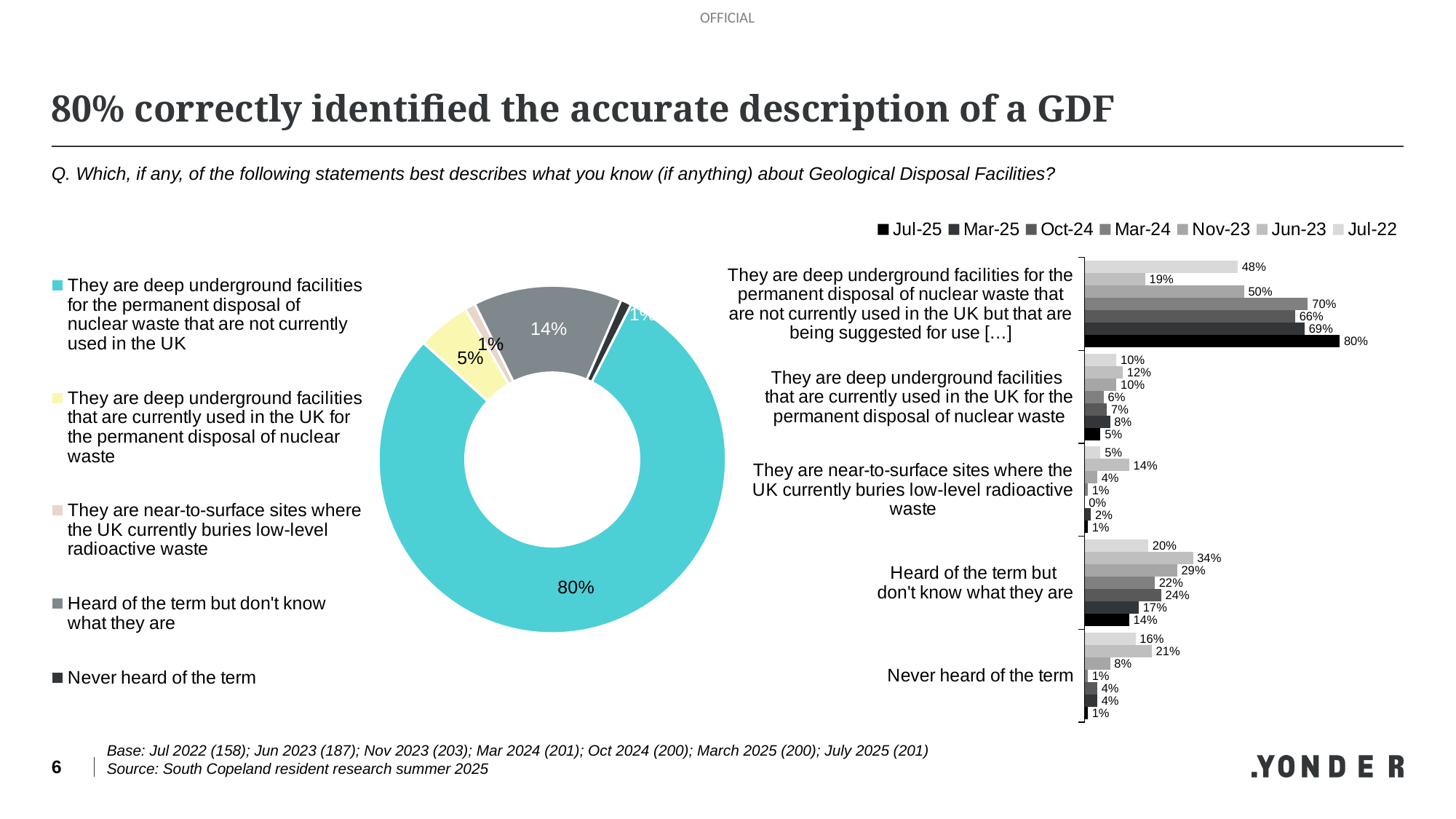
On the bar chart on the right, what is the Jul-22 value for 'Heard of the term but don't know what they are'? 20% What type of chart is on the right side of the slide? Bar chart How many series does the legend of the bar chart on the right list? 7 On the bar chart on the right, what is the difference between the Jul-25 and Jul-22 values for the first statement (deep underground facilities not currently used in the UK)? 32 percentage points On the donut chart, what percentage had heard of the term but don't know what they are? 14% On the bar chart on the right, what is the highest value shown for 'Heard of the term but don't know what they are'? 34% On the donut chart, what share of respondents said GDFs are deep underground facilities for the permanent disposal of nuclear waste that are not currently used in the UK? 80% On the donut chart, which statement has the largest share? They are deep underground facilities for the permanent disposal of nuclear waste that are not currently used in the UK How many categories does the donut chart's legend list? 5 On the bar chart on the right, which is larger for 'Never heard of the term': the Jul-22 value or the Jul-25 value? Jul-22 On the bar chart on the right, what is the Jul-25 value for 'They are deep underground facilities for the permanent disposal of nuclear waste that are not currently used in the UK but that are being suggested for use'? 80% On the donut chart, what percentage said they are deep underground facilities currently used in the UK for the permanent disposal of nuclear waste? 5%